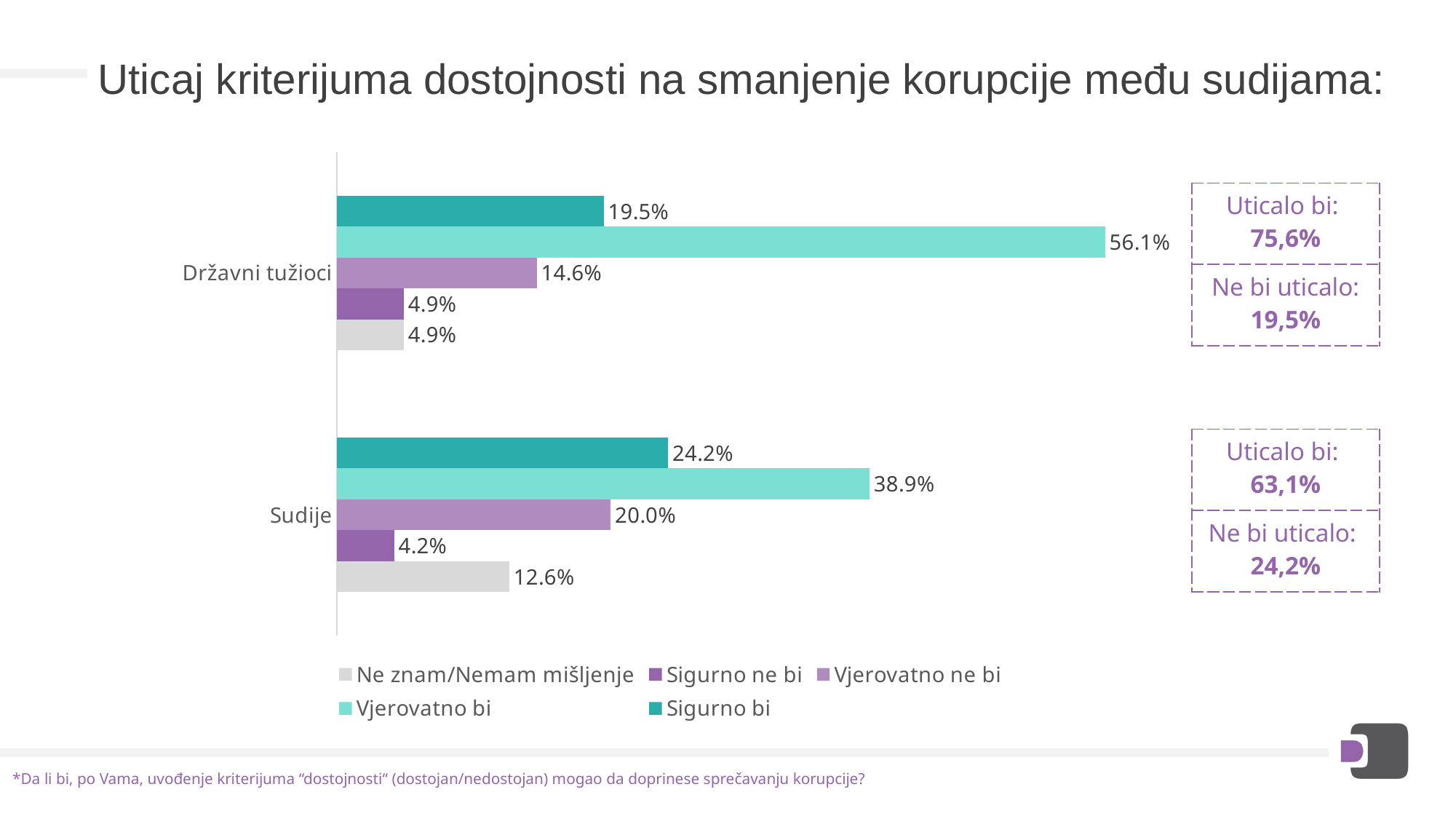
What is the value for "Vjerovatno bi" for Državni tužioci? 56.1% How many categories are shown on the chart? 2 How many series does the legend list? 5 Which series has the highest value for Sudije? Vjerovatno bi What is the value for "Ne znam/Nemam mišljenje" for Sudije? 12.6% Which category has the larger value for "Ne znam/Nemam mišljenje", Državni tužioci or Sudije? Sudije Which series has the lowest value for Sudije? Sigurno ne bi Which category has the larger value for "Sigurno bi", Državni tužioci or Sudije? Sudije What is the value for "Vjerovatno ne bi" for Državni tužioci? 14.6% What is the value for "Sigurno bi" for Sudije? 24.2% What kind of chart is shown on the slide? Bar chart What is the difference between the "Vjerovatno bi" values for Državni tužioci and Sudije? 17.2%